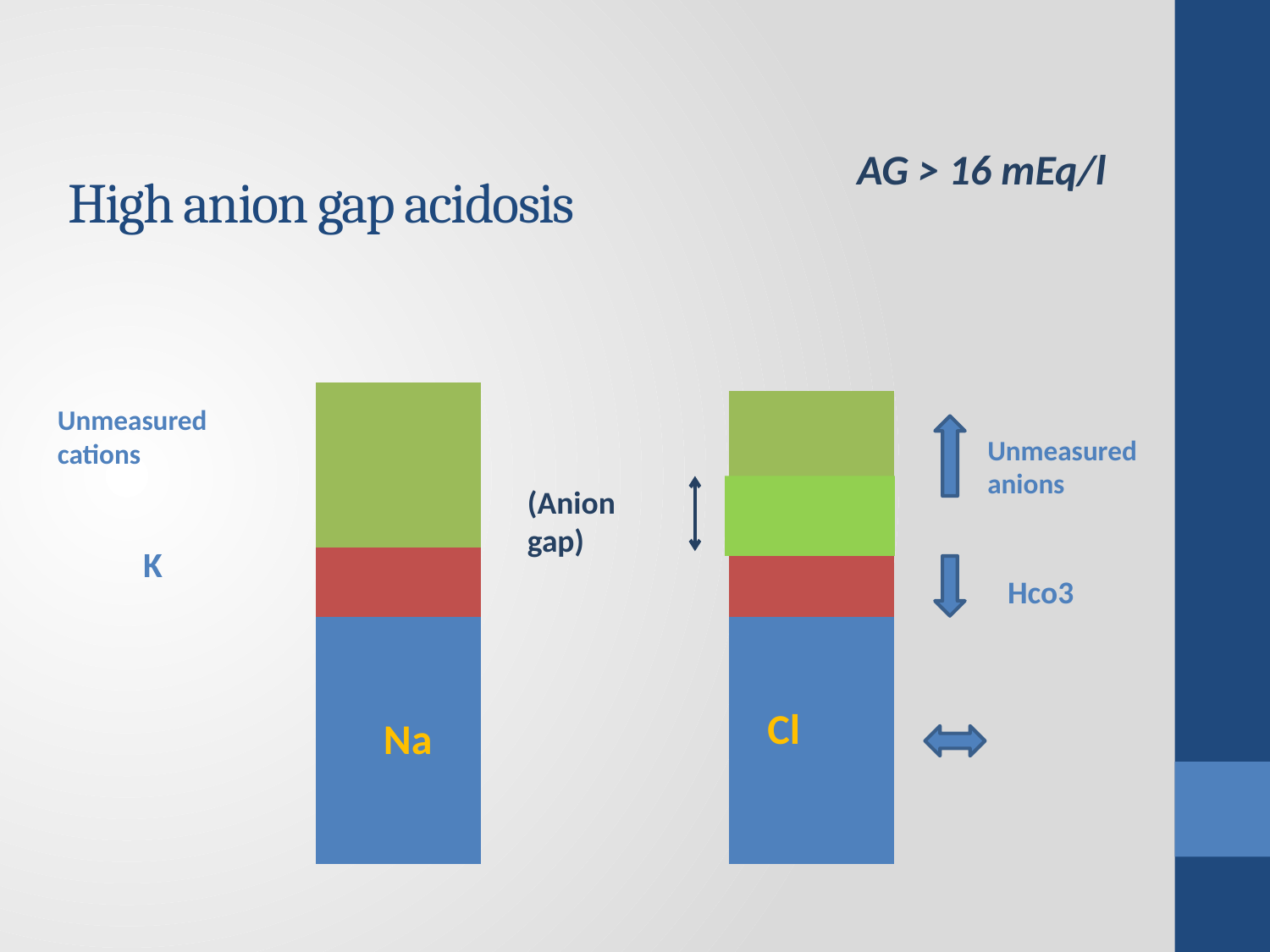
What label is printed on the bottom segment of the right bar? Cl What kind of chart is shown on the slide? stacked bar chart In the left bar, which segment is taller, the green segment or the red segment? the green segment How many coloured segments make up the right bar? 4 How many coloured segments make up the left bar? 3 What label is printed on the bottom segment of the left bar? Na How many bars are shown on the slide? 2